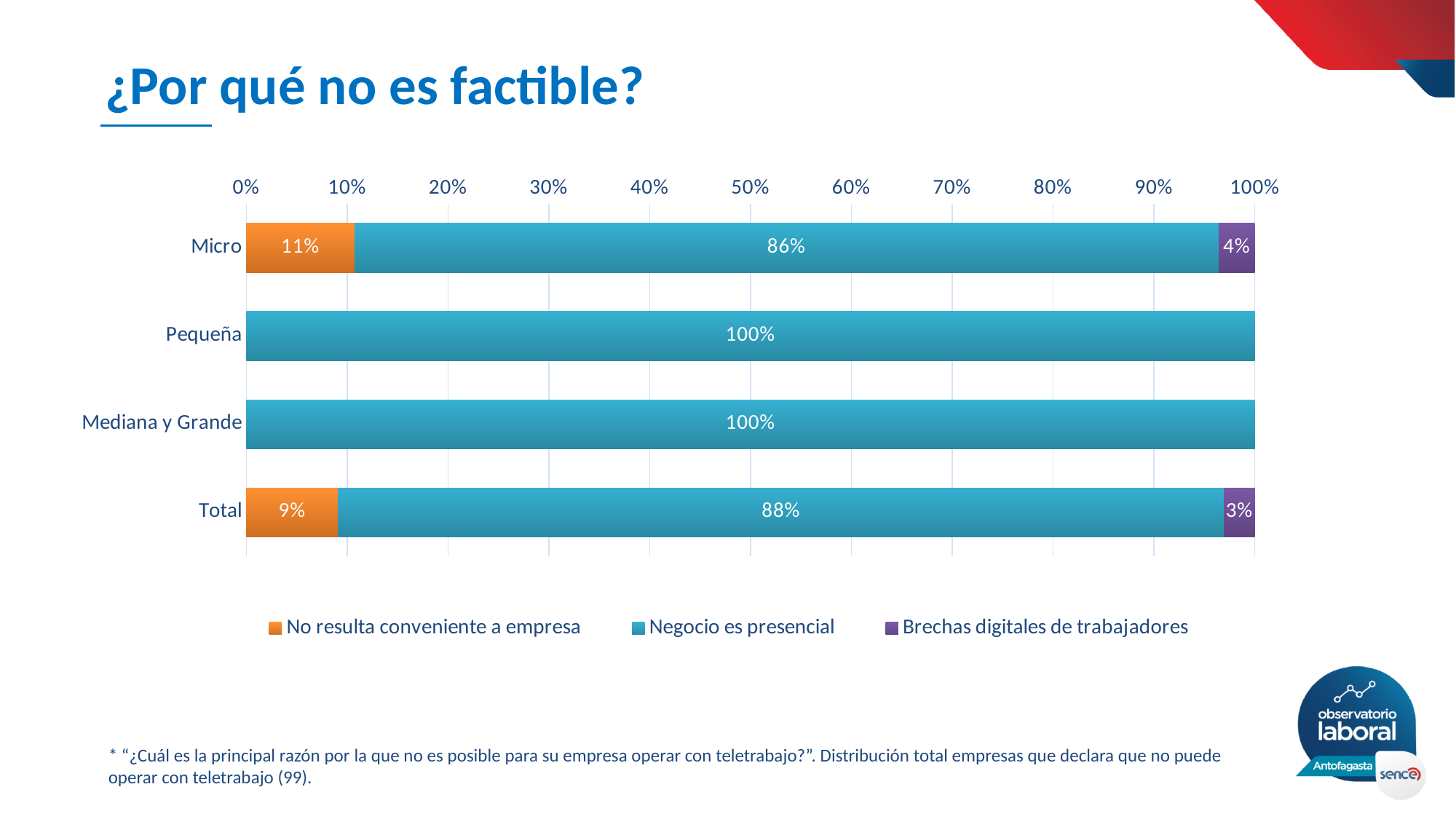
What is the difference between the "Negocio es presencial" values for Total and Micro? 2% Which category has the lowest value for "Negocio es presencial"? Micro How many series does the legend list? 3 What is the value for "No resulta conveniente a empresa" in the Total category? 9% How many categories are shown on the y axis? 4 What is the value for "Brechas digitales de trabajadores" in the Micro category? 4% What is the title of the slide? ¿Por qué no es factible? What kind of chart is shown on the slide? Stacked bar chart Which category has the highest value for "No resulta conveniente a empresa"? Micro Which is larger: the "No resulta conveniente a empresa" value for Micro or for Total? Micro What is the value for "Negocio es presencial" in the Pequeña category? 100% What is the value for "Negocio es presencial" in the Micro category? 86%